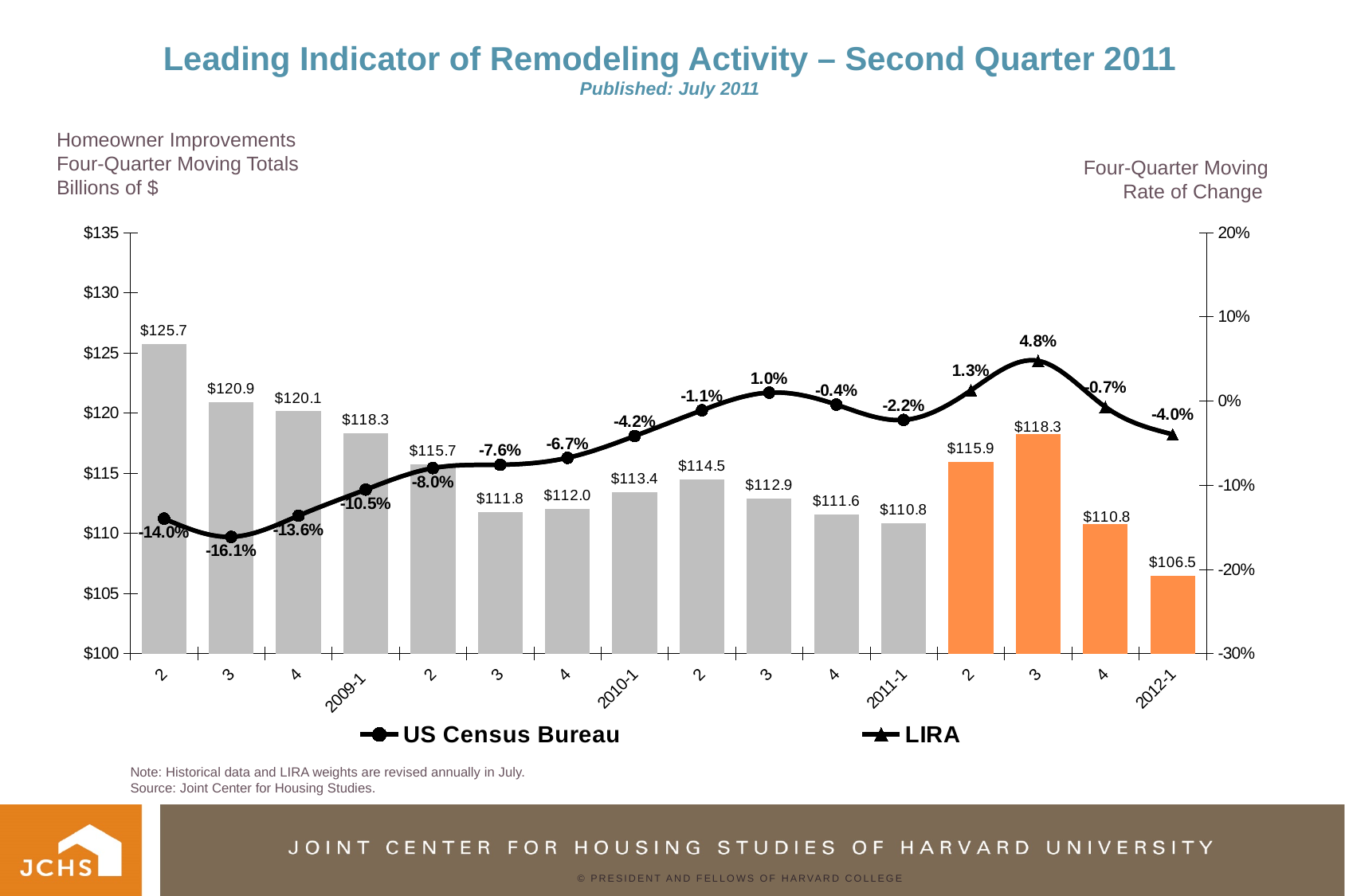
Which bar has the lowest four-quarter moving total? 2012-1 What is the difference between the four-quarter moving totals for 2011-1 and 2012-1? $4.3 Which bar has the highest four-quarter moving total? The first (leftmost) bar, labelled 2, at $125.7 What is the four-quarter moving rate of change shown at 2009-1? -10.5% How many series does the legend list? 2 What is the four-quarter moving rate of change shown at 2012-1? -4.0% What is the highest rate of change value shown on the line? 4.8% Which has the larger four-quarter moving total, 2010-1 or 2011-1? 2010-1 What are the two entries in the chart legend? US Census Bureau and LIRA What is the four-quarter moving total for 2012-1? $106.5 What is the four-quarter moving total for 2009-1? $118.3 How many bars are plotted in the chart? 16